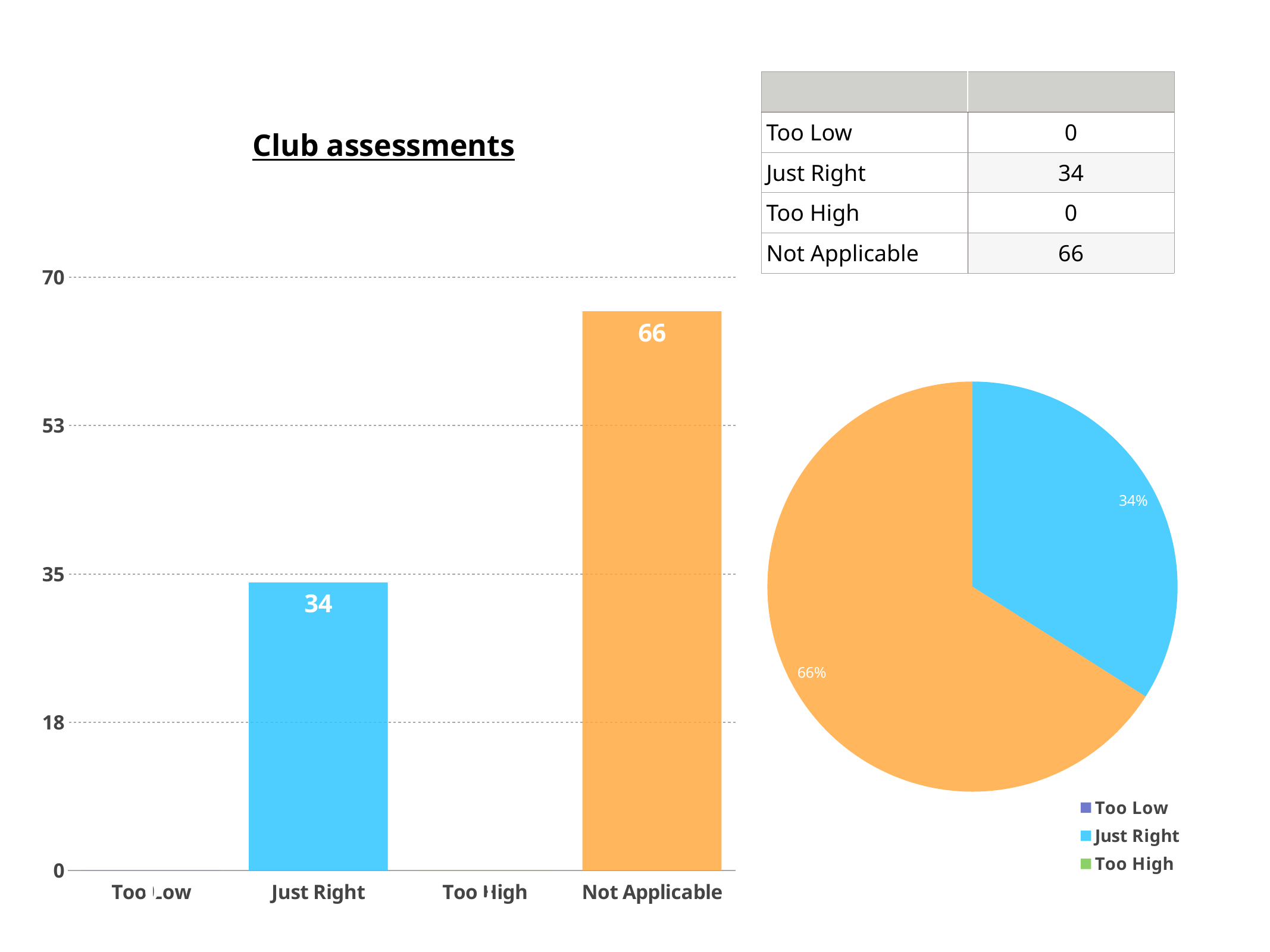
How many entries does the legend of the pie chart on the lower right of the slide list? 3 In the bar chart titled "Club assessments", which category has the highest value? Not Applicable In the bar chart titled "Club assessments", what is the value for Just Right? 34 In the bar chart titled "Club assessments", is the value for Not Applicable greater or less than 53? greater In the pie chart on the lower right of the slide, what share is shown for the blue slice? 34% In the bar chart titled "Club assessments", what is the difference between the values for Not Applicable and Just Right? 32 How many categories are shown on the x axis of the bar chart titled "Club assessments"? 4 In the bar chart titled "Club assessments", which is larger, the value for Just Right or the value for Not Applicable? Not Applicable What kind of chart is the chart titled "Club assessments" on the left of the slide? bar chart In the pie chart on the lower right of the slide, what share is shown for the orange slice? 66% What kind of chart is shown on the lower right of the slide? pie chart In the bar chart titled "Club assessments", what is the value for Not Applicable? 66